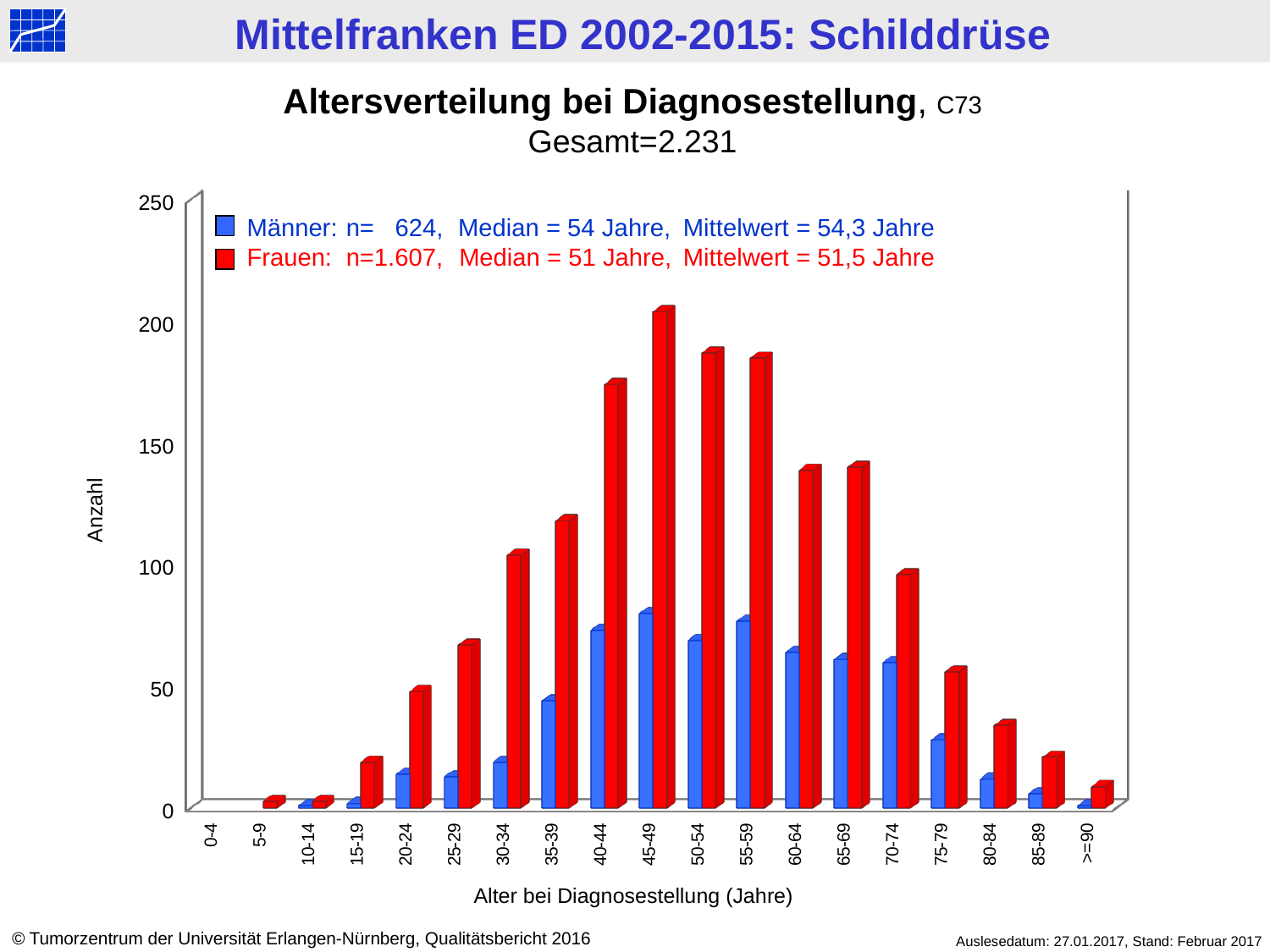
In the 45-49 age group, which series has the larger value, Männer or Frauen? Frauen Is the value for Männer in the 35-39 age group greater or less than 50? less How many series does the legend list? 2 What kind of chart is shown on the slide? bar chart For Frauen, which age group has the larger value, 35-39 or 40-44? 40-44 Which age group has the highest value for Frauen? 45-49 According to the legend, what is n for Männer? 624 Is the value for Frauen in the 45-49 age group greater or less than 200? greater How many age groups are shown on the x axis? 19 Is the value for Männer in the 45-49 age group greater or less than 50? greater According to the legend, what is the Median age for Frauen? 51 Jahre